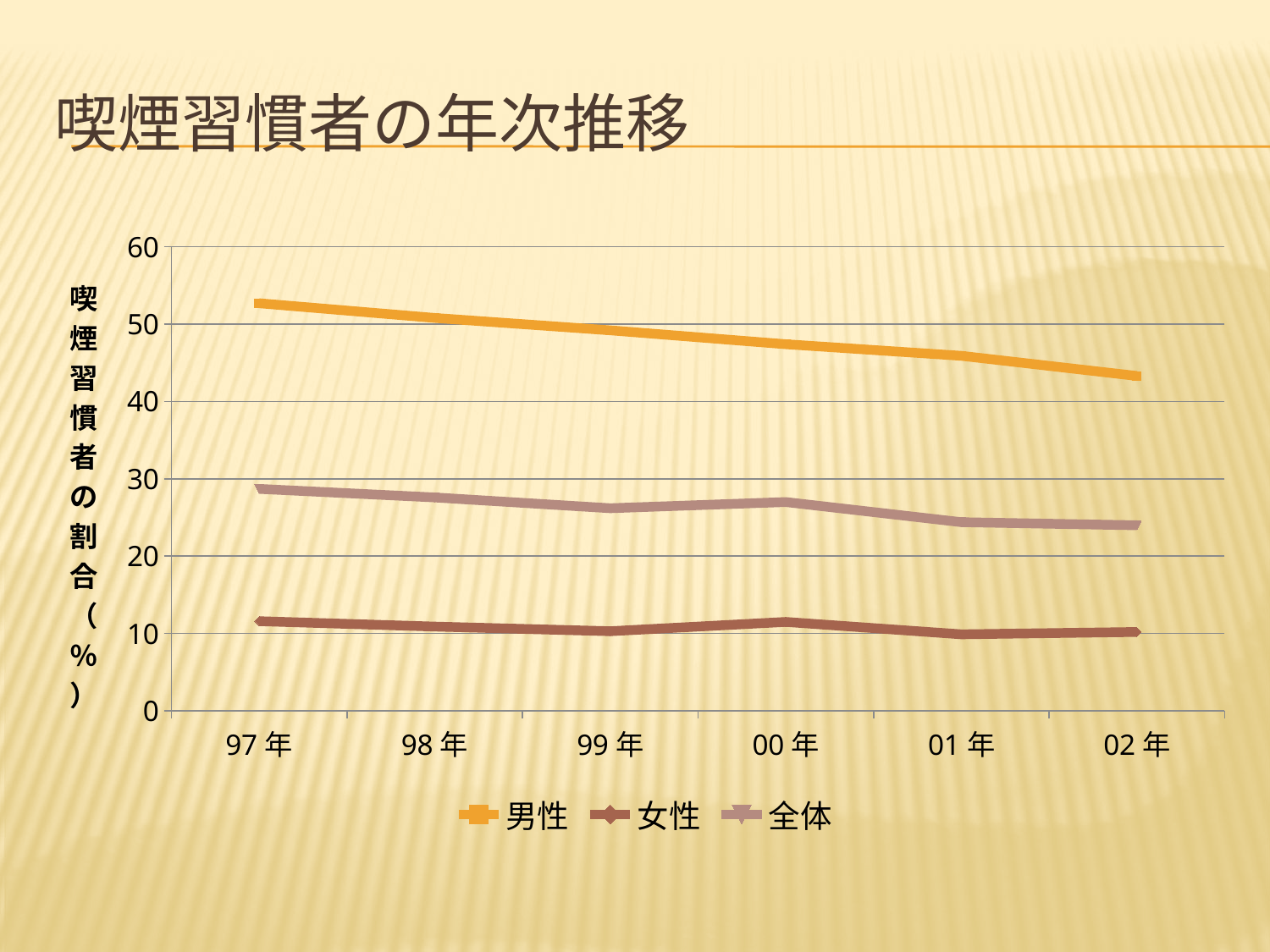
Does the 男性 line rise or fall from 97年 to 02年? fall What kind of chart is shown on the slide? line chart Which is larger, the value for 全体 in 97年 or the value for 全体 in 02年? 97年 How many years are plotted along the x axis? 6 Is the value for 男性 in 02年 greater or less than 50? less Is the value for 全体 in 97年 greater or less than 30? less Is the value for 女性 in 97年 greater or less than 10? greater Which series has the lowest values across all years? 女性 How many series does the legend list? 3 What is the title of the chart on the slide? 喫煙習慣者の年次推移 Which series has the highest values across all years? 男性